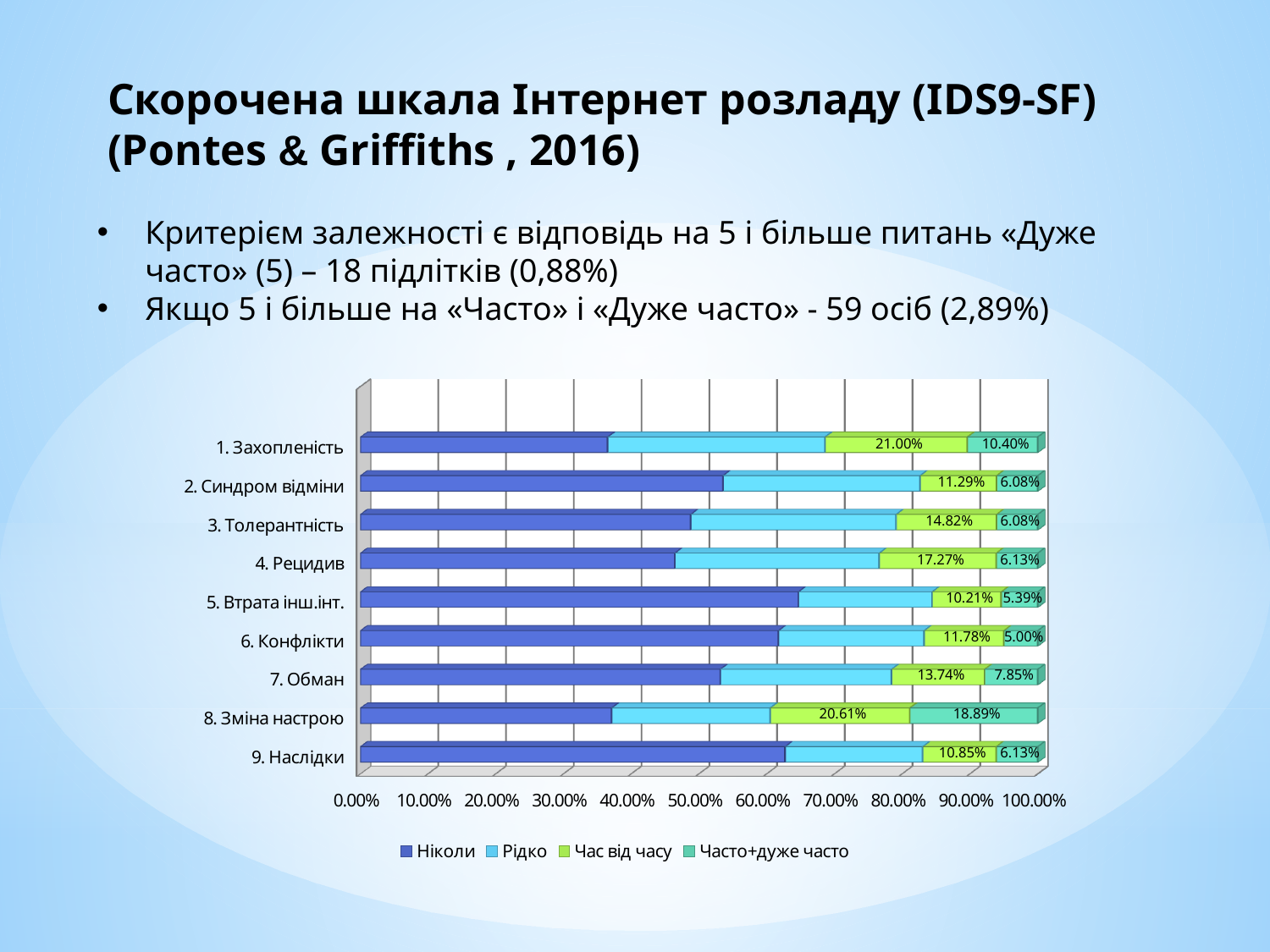
Which category has the lowest value in the "Часто+дуже часто" series? 6. Конфлікти What is the value of the "Час від часу" series for "4. Рецидив"? 17.27% What is the value of the "Час від часу" series for "1. Захопленість"? 21.00% What is the value of the "Часто+дуже часто" series for "8. Зміна настрою"? 18.89% What kind of chart is shown on the slide? Stacked bar chart Which is larger: the "Часто+дуже часто" value for "7. Обман" or for "9. Наслідки"? 7. Обман Which category has the lowest value in the "Час від часу" series? 5. Втрата інш.інт. Is the "Ніколи" value for "8. Зміна настрою" greater or less than 40.00%? less Which category has the highest value in the "Часто+дуже часто" series? 8. Зміна настрою How many series does the legend list? 4 What is the difference between the "Час від часу" values for "1. Захопленість" and "8. Зміна настрою"? 0.39% How many categories are shown on the chart? 9